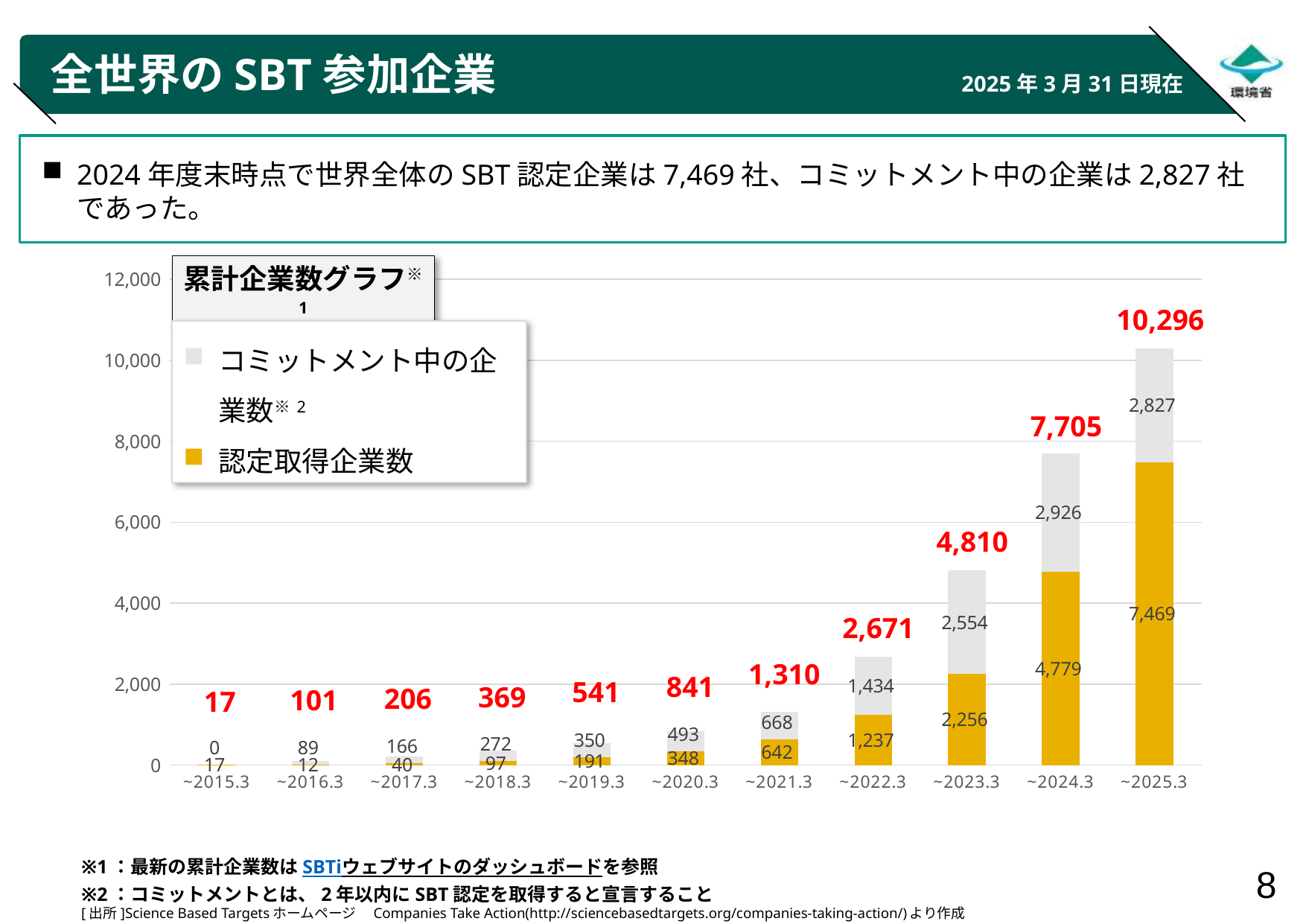
Which colour represents 認定取得企業数 in the chart? Gold (yellow) What is the number of コミットメント中の企業数 for ~2024.3? 2,926 Do the total values rise or fall from ~2015.3 to ~2025.3? Rise For ~2022.3, which is larger: コミットメント中の企業数 or 認定取得企業数? コミットメント中の企業数 What is the difference between the 認定取得企業数 for ~2025.3 and ~2024.3? 2,690 How many series does the legend list? 2 Which category has the lowest total number of companies? ~2015.3 What is the number of 認定取得企業数 for ~2025.3? 7,469 Which category has the highest total number of companies? ~2025.3 How many categories are shown on the x axis? 11 What is the total (stacked) value shown above the bar for ~2023.3? 4,810 What kind of chart is shown on the slide? Stacked bar chart